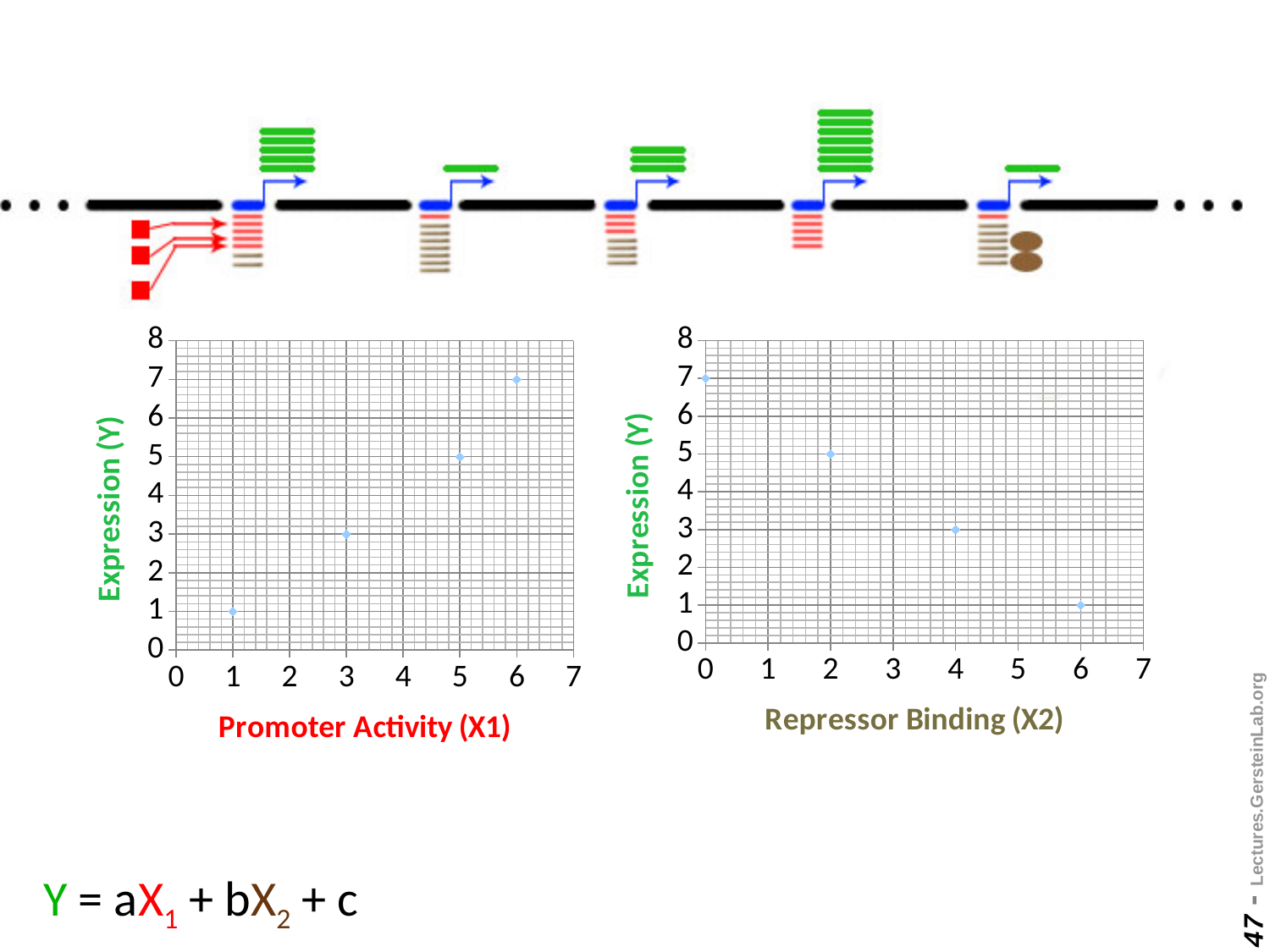
What kind of chart is the left chart with x axis Promoter Activity (X1)? scatter chart In the right chart, what is the Expression (Y) value at Repressor Binding (X2) = 0? 7 In the right chart, what is the difference in Expression (Y) between Repressor Binding (X2) = 0 and X2 = 6? 6 In the right chart, does Expression (Y) rise or fall as Repressor Binding (X2) increases? fall In the right chart, what is the Expression (Y) value at Repressor Binding (X2) = 6? 1 In the left chart (Promoter Activity), how many data points are plotted? 4 In the left chart, what is the Expression (Y) value at Promoter Activity (X1) = 6? 7 In the left chart, which Promoter Activity (X1) value has the lowest Expression (Y)? 1 In the right chart (Repressor Binding), how many data points are plotted? 4 What is the label of the x axis on the right chart? Repressor Binding (X2) In the left chart, does Expression (Y) rise or fall as Promoter Activity (X1) increases? rise In the left chart, what is the Expression (Y) value at Promoter Activity (X1) = 3? 3